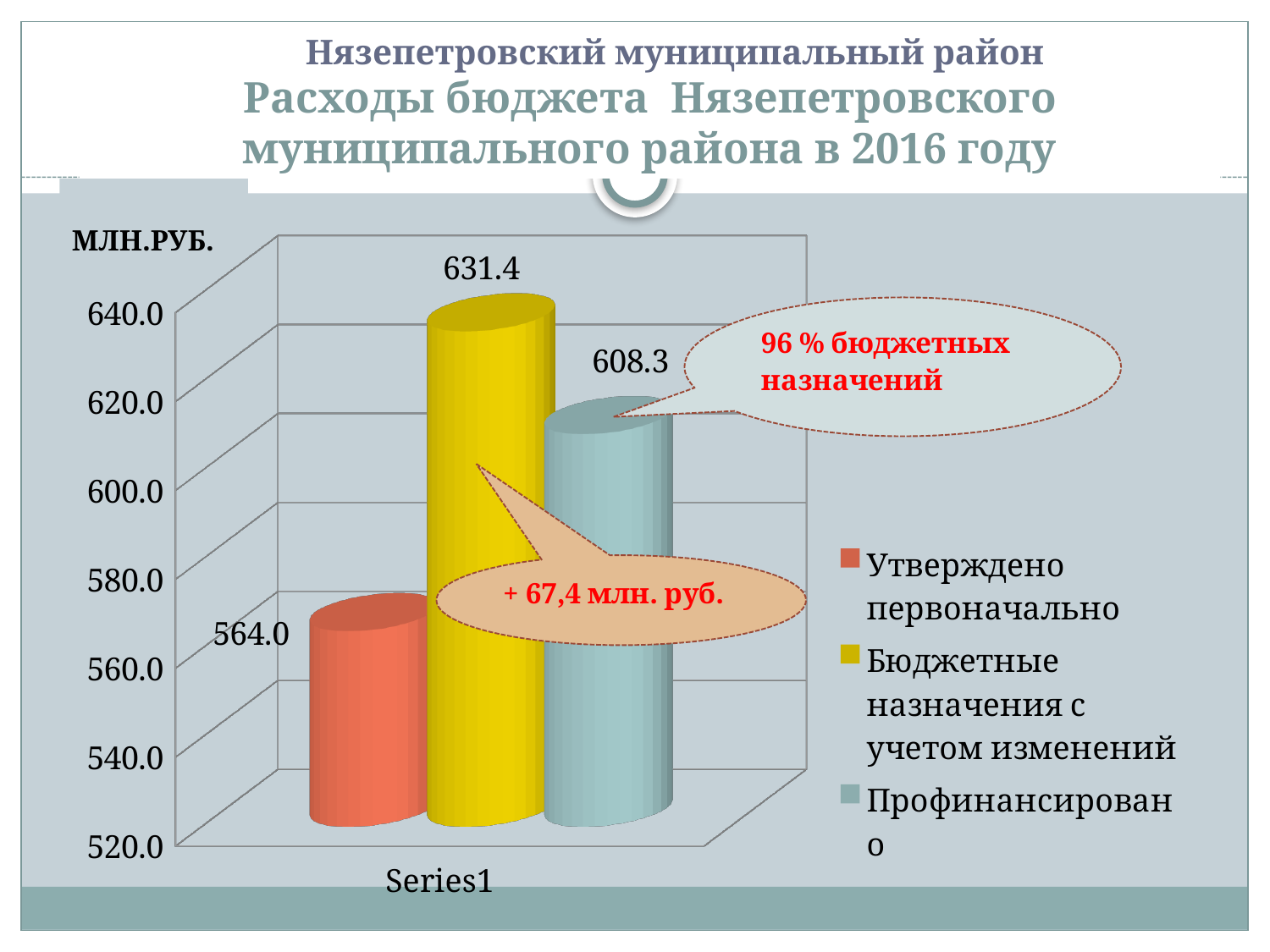
What unit is shown above the vertical axis of the chart? МЛН.РУБ. What is the value for "Бюджетные назначения с учетом изменений"? 631.4 Which series has the highest value? Бюджетные назначения с учетом изменений What is the difference between "Бюджетные назначения с учетом изменений" and "Профинансировано"? 23.1 Is the value for "Профинансировано" greater or less than 600.0? greater What is the value for "Утверждено первоначально"? 564.0 How many series does the legend list? 3 Which is larger: "Профинансировано" or "Утверждено первоначально"? Профинансировано What kind of chart is shown on the slide? bar chart What is the difference between "Бюджетные назначения с учетом изменений" and "Утверждено первоначально"? 67.4 Which series has the lowest value? Утверждено первоначально What is the value for "Профинансировано"? 608.3